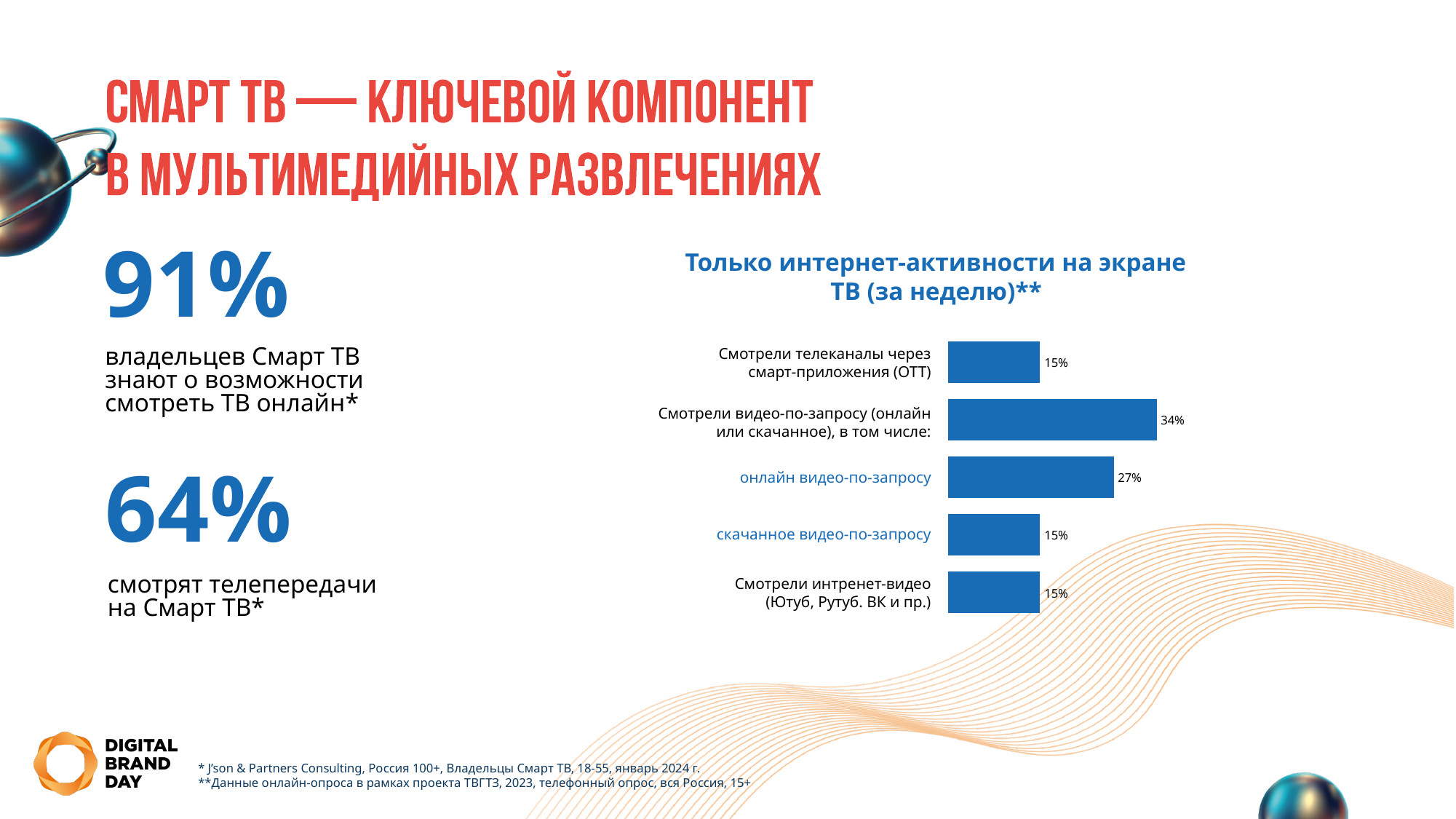
Which category has the highest value? Смотрели видео-по-запросу (онлайн или скачанное), в том числе: How many categories in the chart have a value of 15%? 3 What is the value for "Смотрели интренет-видео (Ютуб, Рутуб. ВК и пр.)"? 15% What kind of chart is shown on the slide? Bar chart What is the difference between the values for "Смотрели видео-по-запросу (онлайн или скачанное), в том числе:" and "онлайн видео-по-запросу"? 7% How many categories are shown in the chart? 5 What is the title of the chart? Только интернет-активности на экране ТВ (за неделю)** What is the value for "Смотрели видео-по-запросу (онлайн или скачанное), в том числе:"? 34% What is the value for "онлайн видео-по-запросу"? 27% Which is larger: the value for "онлайн видео-по-запросу" or the value for "скачанное видео-по-запросу"? онлайн видео-по-запросу What is the value for "Смотрели телеканалы через смарт-приложения (ОТТ)"? 15% What is the difference between the values for "онлайн видео-по-запросу" and "скачанное видео-по-запросу"? 12%